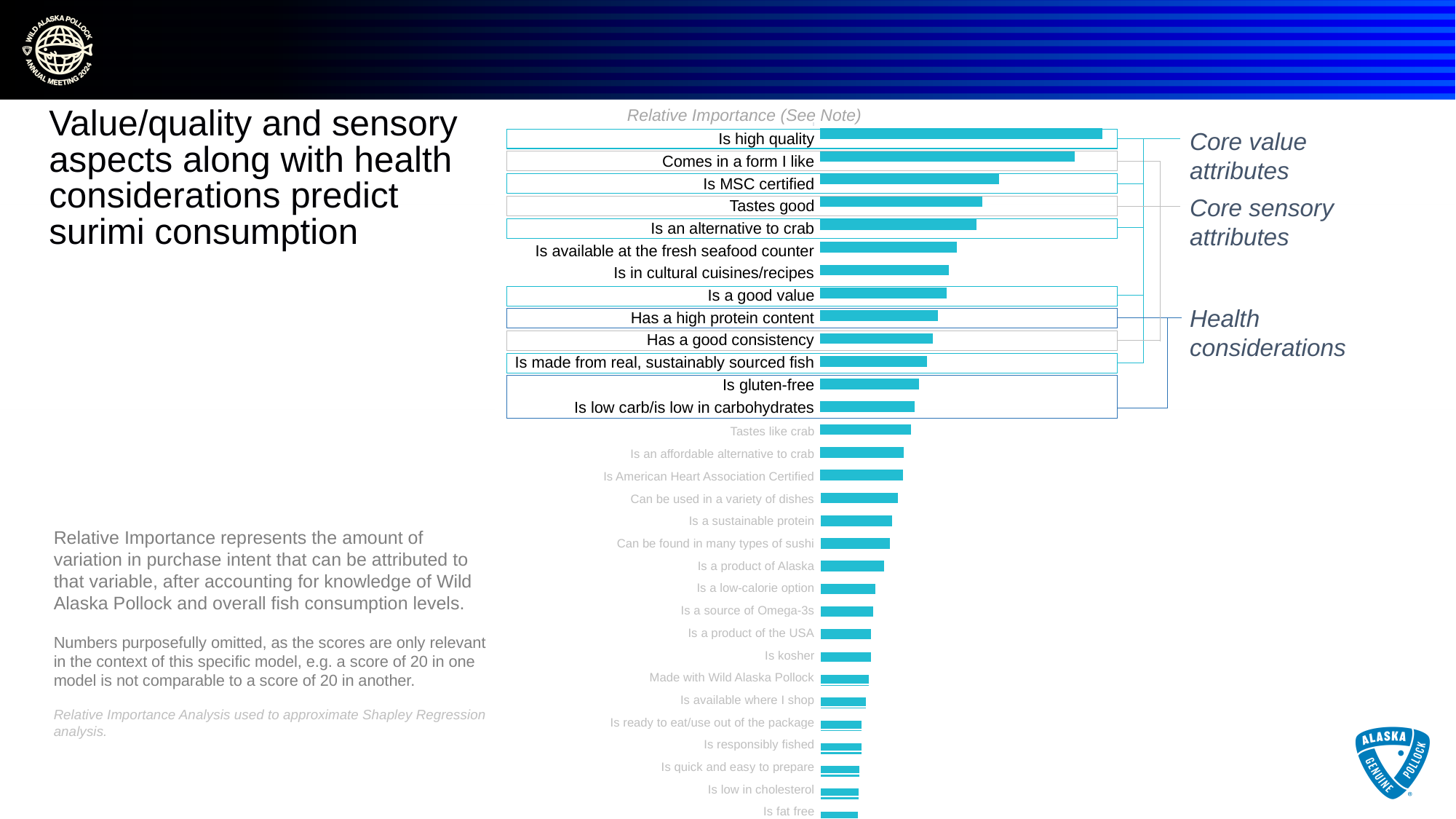
Which has the larger bar: 'Is kosher' or 'Is a good value'? Is a good value Which has the larger bar: 'Is high quality' or 'Tastes good'? Is high quality Do the bar lengths increase or decrease going from the top of the chart to the bottom? Decrease Which attribute appears second from the top of the chart? Comes in a form I like Which has the larger bar: 'Is MSC certified' or 'Is gluten-free'? Is MSC certified Which attribute has the highest relative importance? Is high quality How many attributes (bars) are plotted in the chart? 31 What kind of chart is shown on the slide? Bar chart How many attribute groupings are annotated to the right of the chart (e.g. Core value attributes)? 3 What is the title of the chart? Relative Importance (See Note)